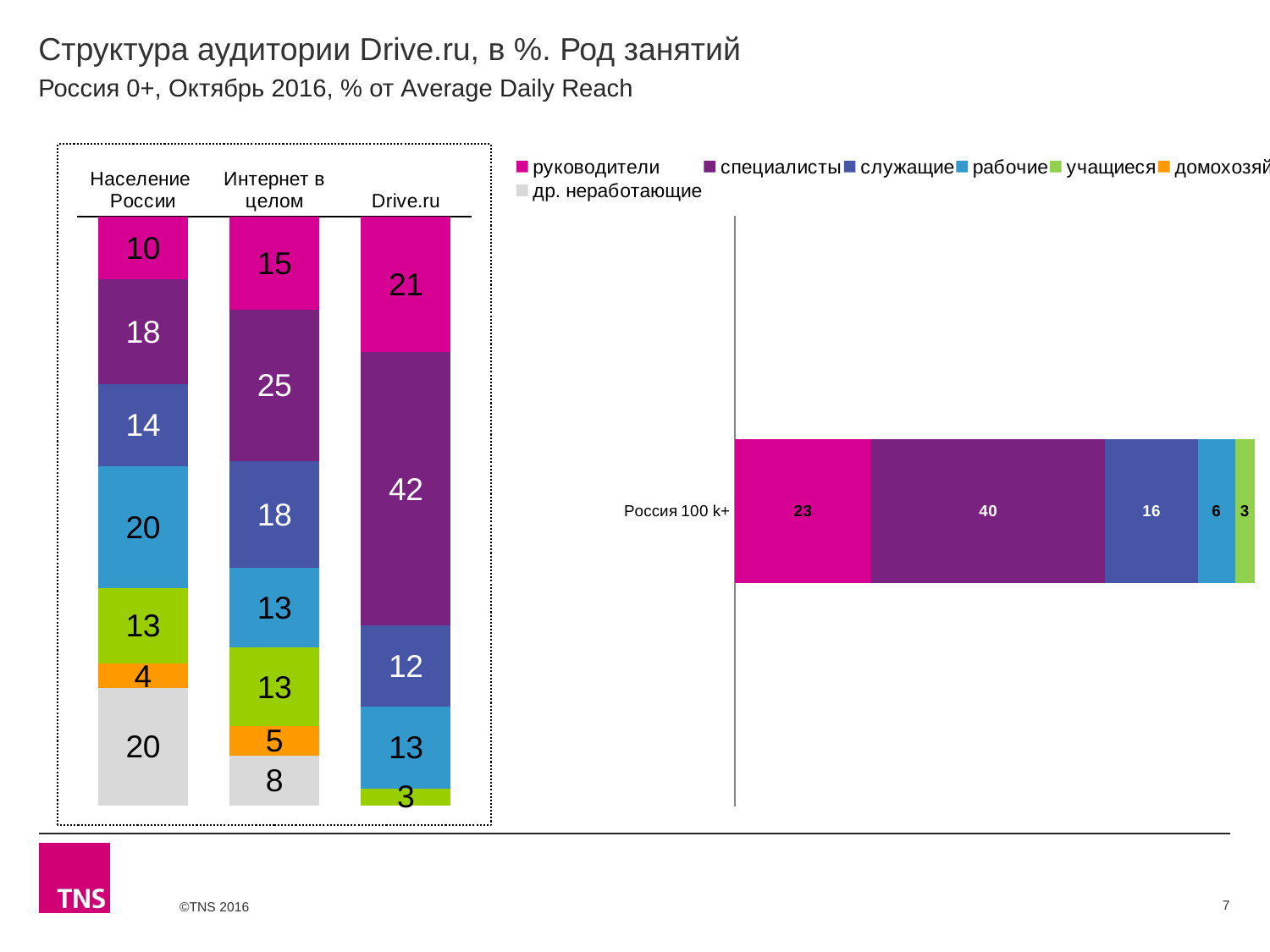
In the left chart, which bar has the highest value for руководители? Drive.ru In the left chart, what is the value for специалисты in the Drive.ru bar? 42 In the left chart, what is the value for руководители in the Население России bar? 10 In the left chart, what is the difference between the специалисты values for Drive.ru and Интернет в целом? 17 How many bars does the left chart show? 3 What kind of chart is the right chart? stacked bar chart How many series does the legend list? 7 In the left chart, which bar has the lowest value for специалисты? Население России In the right chart, is the value for руководители larger or smaller than the value for служащие? larger In the right chart, what is the value for специалисты for Россия 100 k+? 40 In the left chart, what is the value for рабочие in the Интернет в целом bar? 13 In the right chart, what is the total of the Россия 100 k+ bar? 88